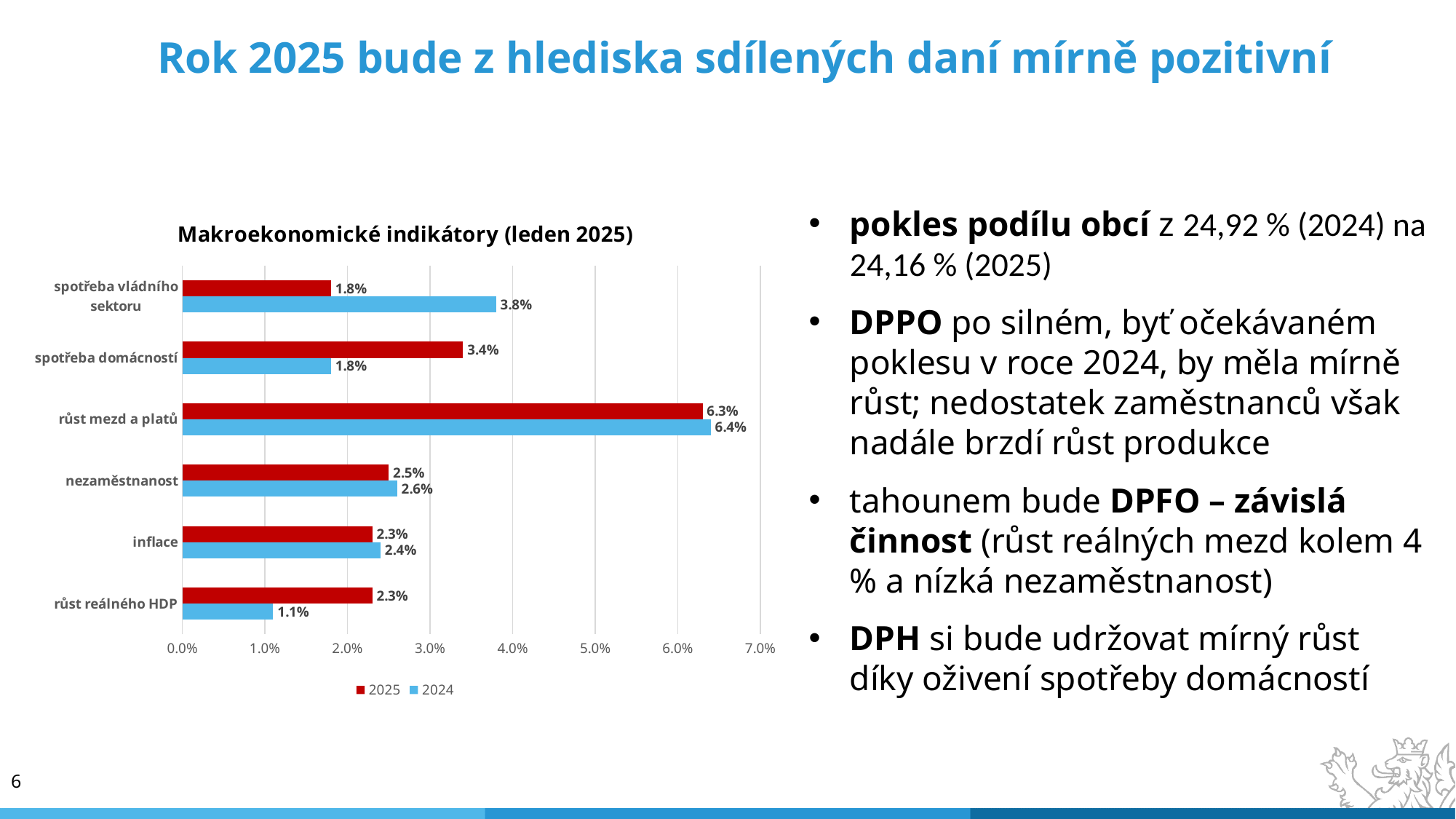
What is the 2024 value for růst mezd a platů? 6.4% What is the 2024 value for spotřeba vládního sektoru? 3.8% Which category has the highest 2025 value? růst mezd a platů What kind of chart is shown on the slide? bar chart Is the 2025 value for růst mezd a platů greater or less than 5.0%? greater How many series does the legend list? 2 Which is larger for spotřeba domácností, the 2025 value or the 2024 value? 2025 What is the title of the chart? Makroekonomické indikátory (leden 2025) What is the 2025 value for růst reálného HDP? 2.3% What is the difference between the 2024 and 2025 values for spotřeba vládního sektoru? 2.0% How many categories are shown on the chart? 6 Which category has the lowest 2024 value? růst reálného HDP